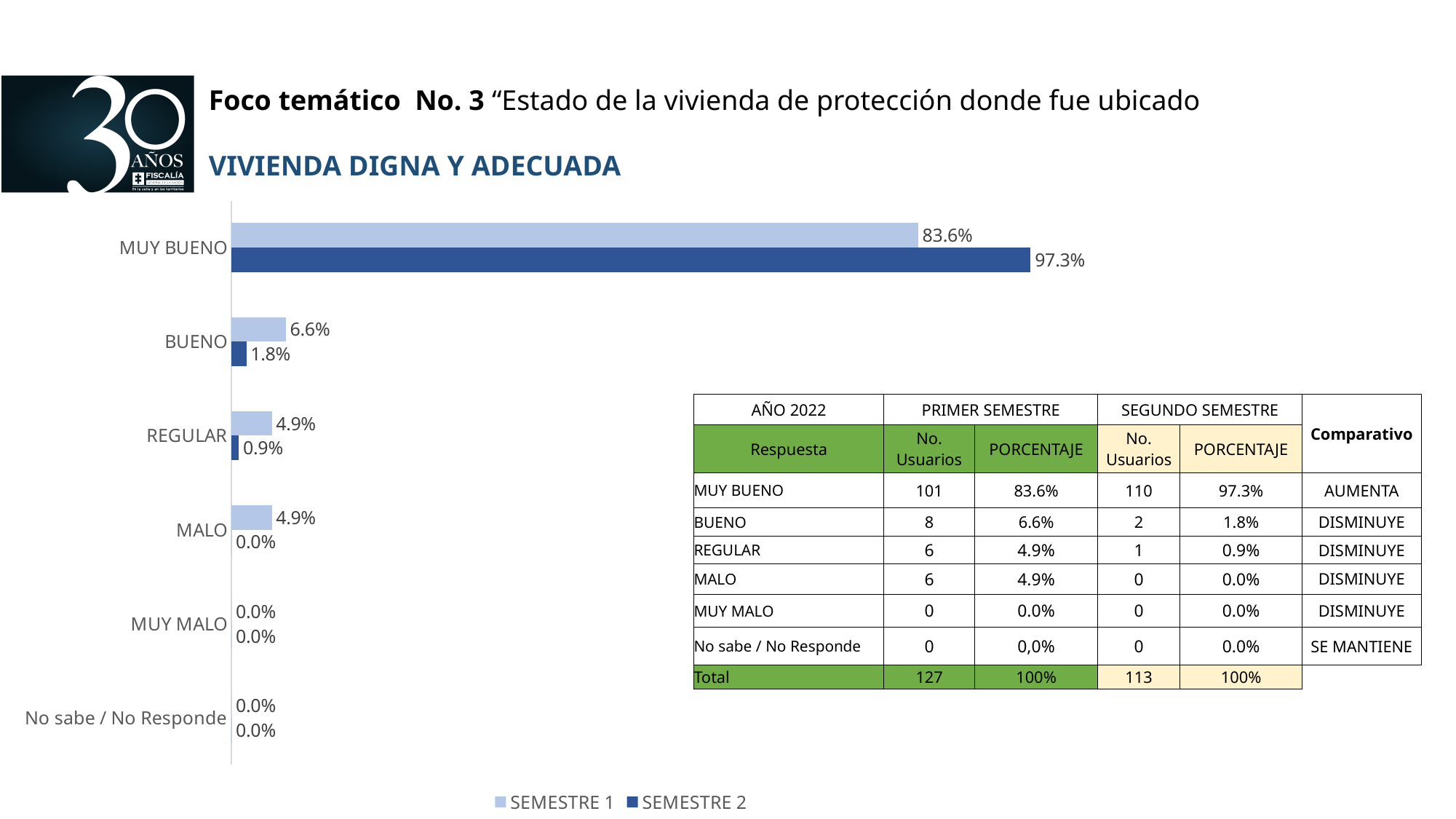
What is the SEMESTRE 2 value for MUY BUENO? 97.3% What is the SEMESTRE 1 value for MUY BUENO? 83.6% What is the SEMESTRE 1 value for BUENO? 6.6% What kind of chart is shown on the slide? Bar chart What is the difference between the SEMESTRE 1 and SEMESTRE 2 values for BUENO? 4.8% What is the SEMESTRE 2 value for REGULAR? 0.9% What is the SEMESTRE 2 value for MALO? 0.0% How many categories are shown on the chart? 6 What is the difference between the SEMESTRE 2 and SEMESTRE 1 values for MUY BUENO? 13.7% How many series does the legend list? 2 Which is larger for REGULAR, the SEMESTRE 1 value or the SEMESTRE 2 value? SEMESTRE 1 Which category has the highest SEMESTRE 2 value? MUY BUENO